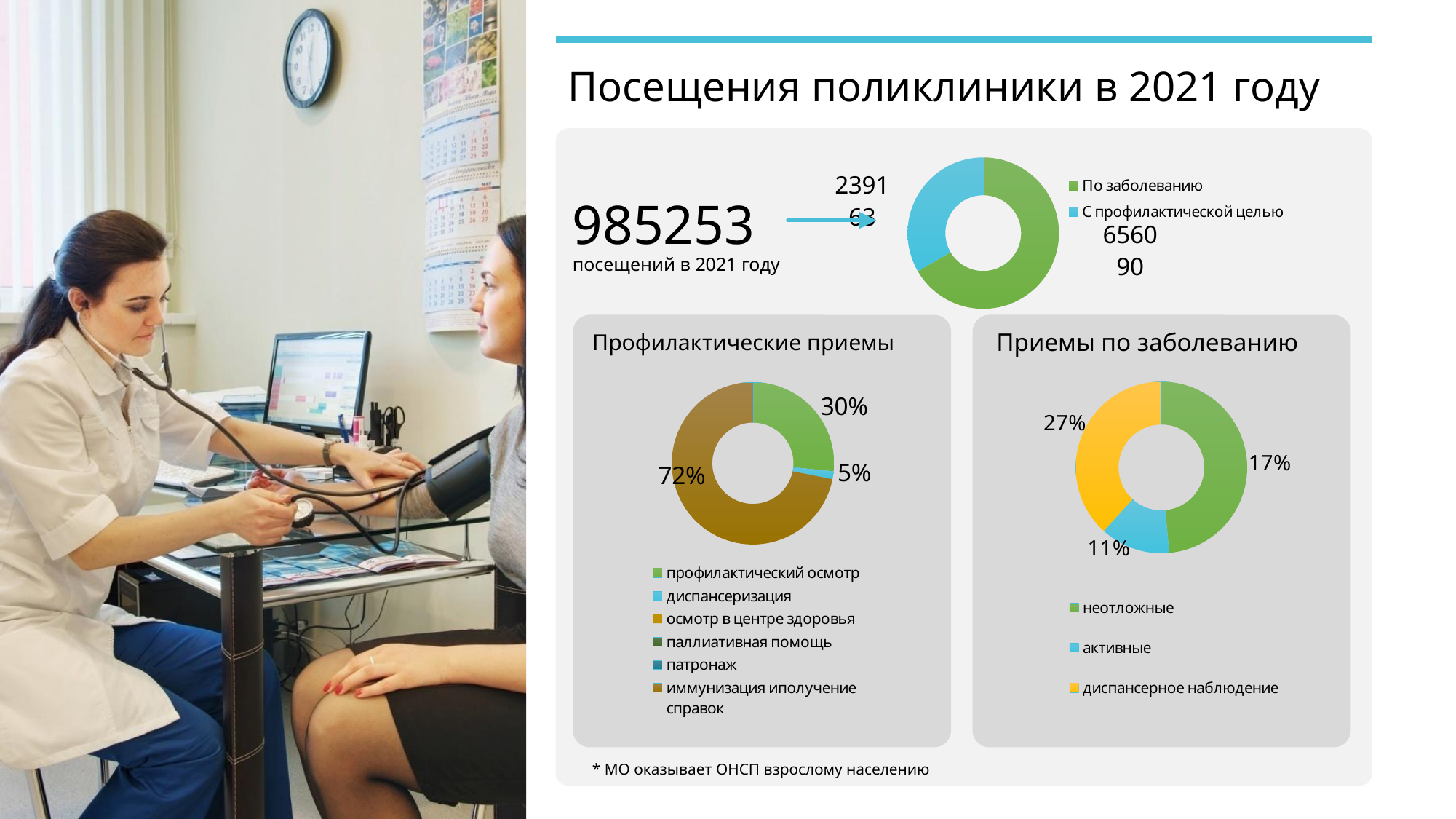
In the 'Приемы по заболеванию' chart, what percentage is shown for 'диспансерное наблюдение'? 27% What kind of chart is used in the 'Приемы по заболеванию' panel? Donut (pie) chart In the 'Приемы по заболеванию' chart, which category has the smallest share? активные In the 'Приемы по заболеванию' chart, what is the difference in percentage points between 'диспансерное наблюдение' and 'активные'? 16 percentage points In the 'Профилактические приемы' chart, what is the largest percentage label shown? 72% How many entries does the legend of the 'Профилактические приемы' chart list? 6 In the 'Профилактические приемы' chart, what percentage is shown for 'диспансеризация'? 5% In the 'Приемы по заболеванию' chart, what percentage is shown for 'неотложные'? 17% In the 'Профилактические приемы' chart, what percentage is shown for 'профилактический осмотр'? 30% In the 'Приемы по заболеванию' chart, what percentage is shown for 'активные'? 11% How many categories does the legend of the 'Приемы по заболеванию' chart list? 3